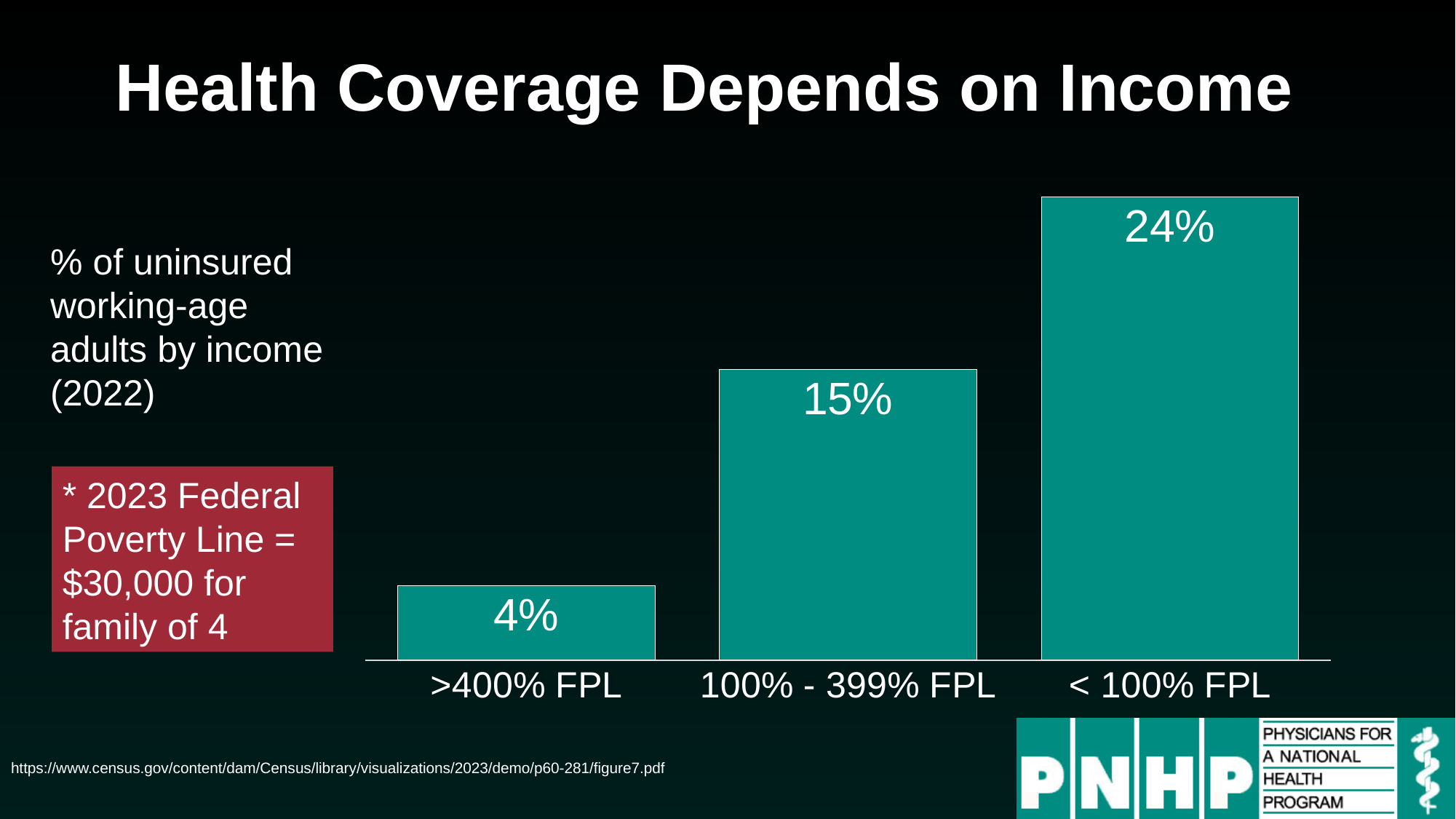
Do the uninsured percentages rise or fall moving from left to right across the income groups? Rise What is the title of the slide containing the chart? Health Coverage Depends on Income What is the percentage of uninsured working-age adults for the 100% - 399% FPL income group? 15% What is the percentage of uninsured working-age adults for the >400% FPL income group? 4% What kind of chart is shown on the slide? Bar chart What is the percentage of uninsured working-age adults for the < 100% FPL income group? 24% What is the difference in uninsured percentage between the 100% - 399% FPL group and the >400% FPL group? 11% Which group has a higher uninsured percentage, 100% - 399% FPL or < 100% FPL? < 100% FPL How many income groups are shown in the chart? 3 What is the difference in uninsured percentage between the < 100% FPL group and the >400% FPL group? 20% Which income group has the highest percentage of uninsured working-age adults? < 100% FPL Which income group has the lowest percentage of uninsured working-age adults? >400% FPL